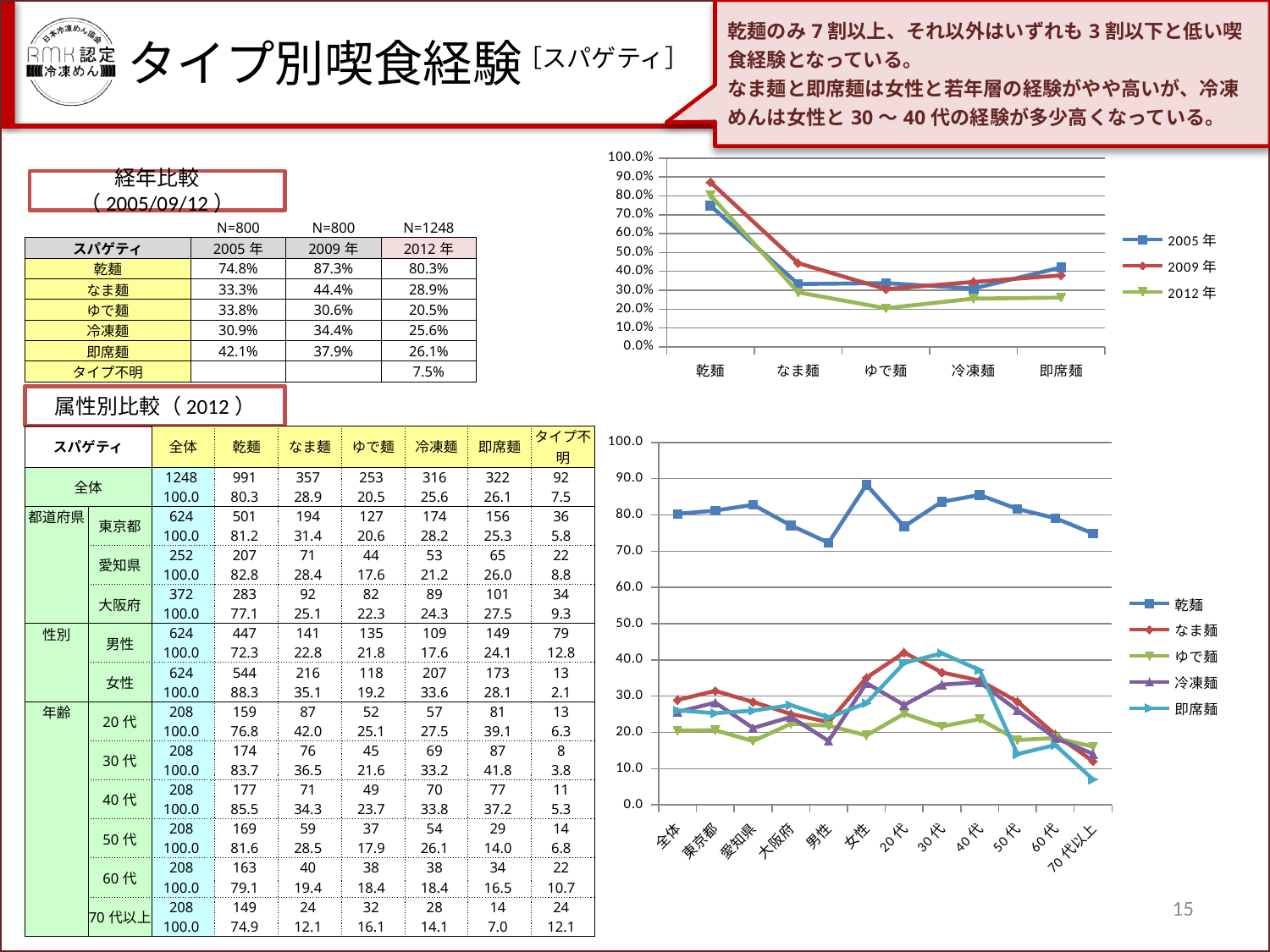
How many categories are shown on the x axis of the top-right chart (経年比較)? 5 In the top-right chart (経年比較), which is larger for ゆで麺: the 2005年 value or the 2012年 value? 2005年 How many series does the legend of the top-right chart (経年比較) list? 3 In the top-right chart (経年比較), which category has the lowest value for the 2012年 series? ゆで麺 How many series does the legend of the bottom-right chart (属性別比較 2012) list? 5 In the bottom-right chart (属性別比較 2012), at which category does the 乾麺 series reach its highest value? 女性 In the top-right chart (経年比較), is the 2005年 value for 乾麺 greater or less than 70.0%? greater In the top-right chart (経年比較), which category has the highest value for the 2009年 series? 乾麺 In the top-right chart (経年比較), do the values rise or fall from 乾麺 to なま麺 for all three series? fall How many categories are shown on the x axis of the bottom-right chart (属性別比較 2012)? 12 What kind of chart is the chart at the top right of the slide (経年比較)? line chart In the bottom-right chart (属性別比較 2012), is the 乾麺 value for 男性 greater or less than 80.0? less